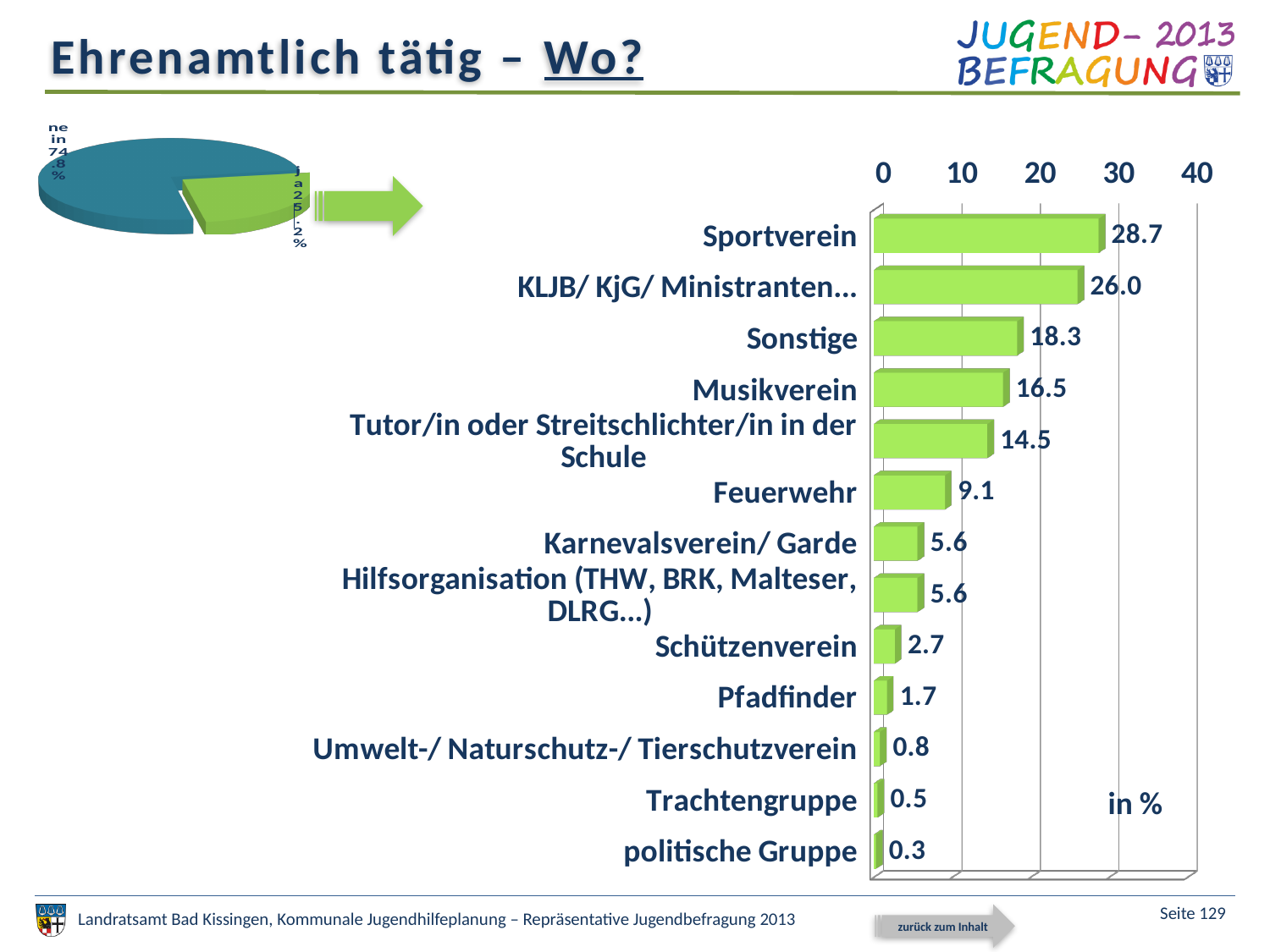
In the bar chart on the right, which category has the highest value? Sportverein In the bar chart on the right, what is the value for Feuerwehr? 9.1 What kind of chart is the chart on the right of the slide? bar chart In the bar chart on the right, which category has the lowest value? politische Gruppe In the bar chart on the right, is the value for Tutor/in oder Streitschlichter/in in der Schule greater or less than 10? greater In the bar chart on the right, what is the difference between the values for Schützenverein and Pfadfinder? 1.0 In the bar chart on the right, what is the value for Sportverein? 28.7 In the bar chart on the right, what is the difference between the values for Sportverein and KLJB/ KjG/ Ministranten...? 2.7 How many categories are shown in the bar chart on the right? 13 In the bar chart on the right, what is the value for Musikverein? 16.5 What unit is indicated for the values in the bar chart on the right? in % In the bar chart on the right, which is larger: the value for Sonstige or the value for Musikverein? Sonstige